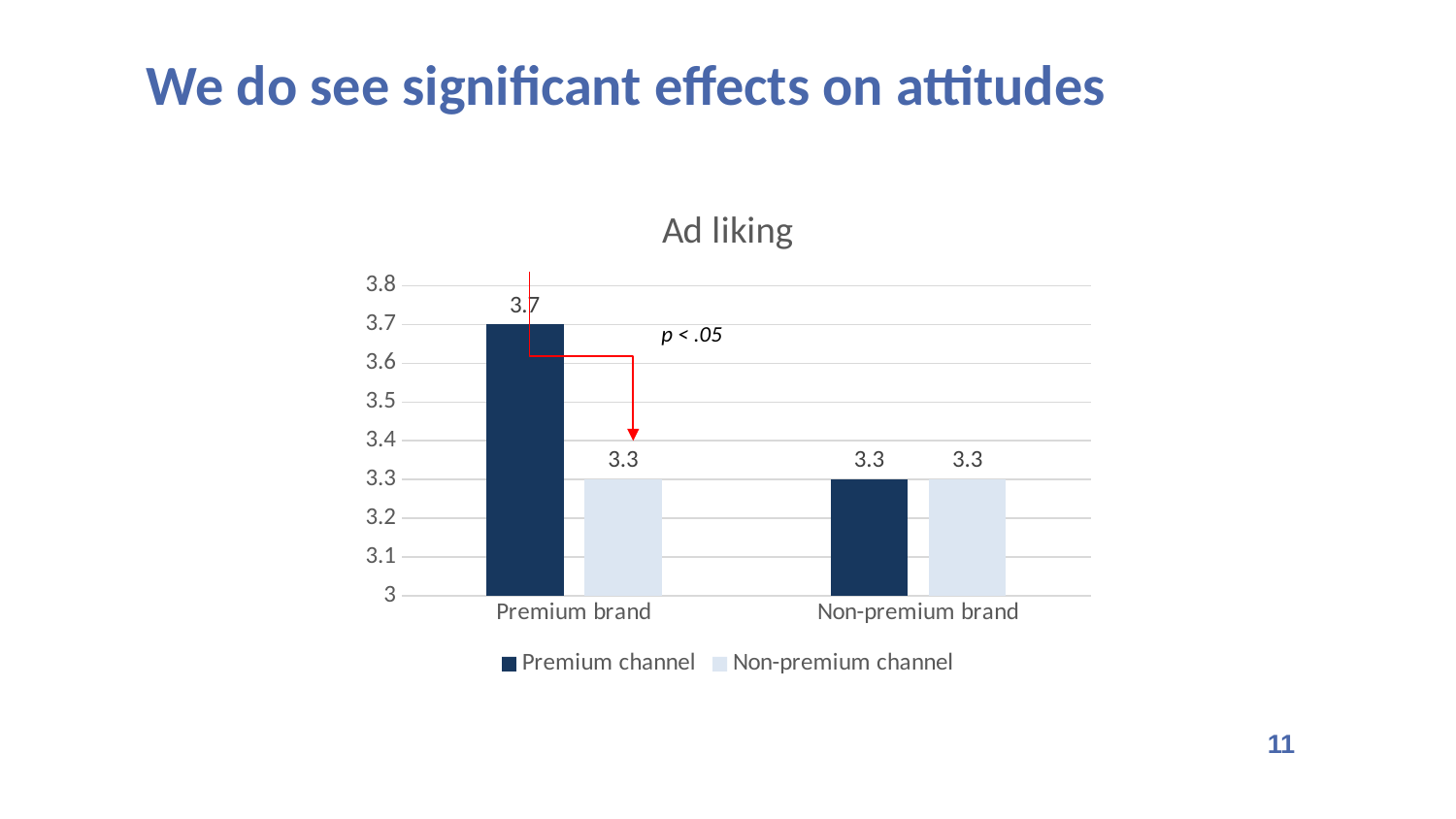
How many brand categories are shown on the x axis? 2 What is the difference between the Premium channel and Non-premium channel values for Premium brand? 0.4 For Premium brand, which is larger: the Premium channel value or the Non-premium channel value? Premium channel What is the title of the chart? Ad liking How many series does the legend list? 2 What is the Ad liking value for Non-premium brand in the Premium channel series? 3.3 What is the Ad liking value for Premium brand in the Non-premium channel series? 3.3 What is the Ad liking value for Non-premium brand in the Non-premium channel series? 3.3 Which bar has the highest Ad liking value? Premium brand, Premium channel What is the Ad liking value for Premium brand in the Premium channel series? 3.7 What kind of chart is shown on the slide? Bar chart Is the Premium channel value for Premium brand greater or less than 3.5? greater